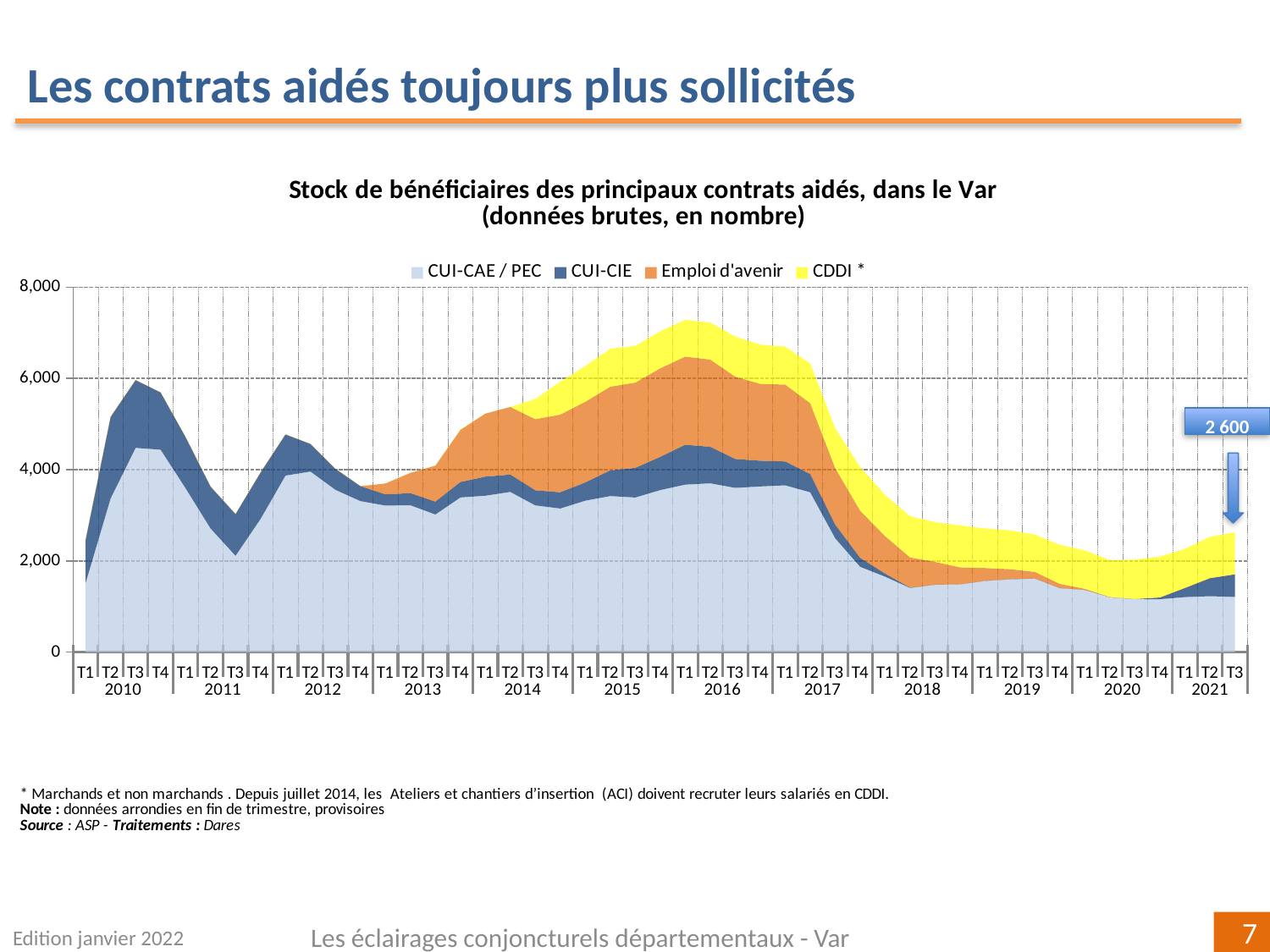
How many series does the legend list? 4 Is the total stock at T1 2016 greater or less than 6,000? greater Is the total stock at T1 2010 greater or less than 4,000? less What kind of chart is shown on the slide? stacked area chart Which series is shown in yellow in the legend? CDDI * Does the total stock rise or fall between T1 2017 and T1 2018? fall What is the title of the chart? Stock de bénéficiaires des principaux contrats aidés, dans le Var (données brutes, en nombre) What value does the annotation give for the total stock at T3 2021? 2 600 In which quarter does the total stock of beneficiaries reach its highest level? T1 2016 How many years are shown on the x axis? 12 Is the total stock at T1 2012 greater or less than 4,000? greater